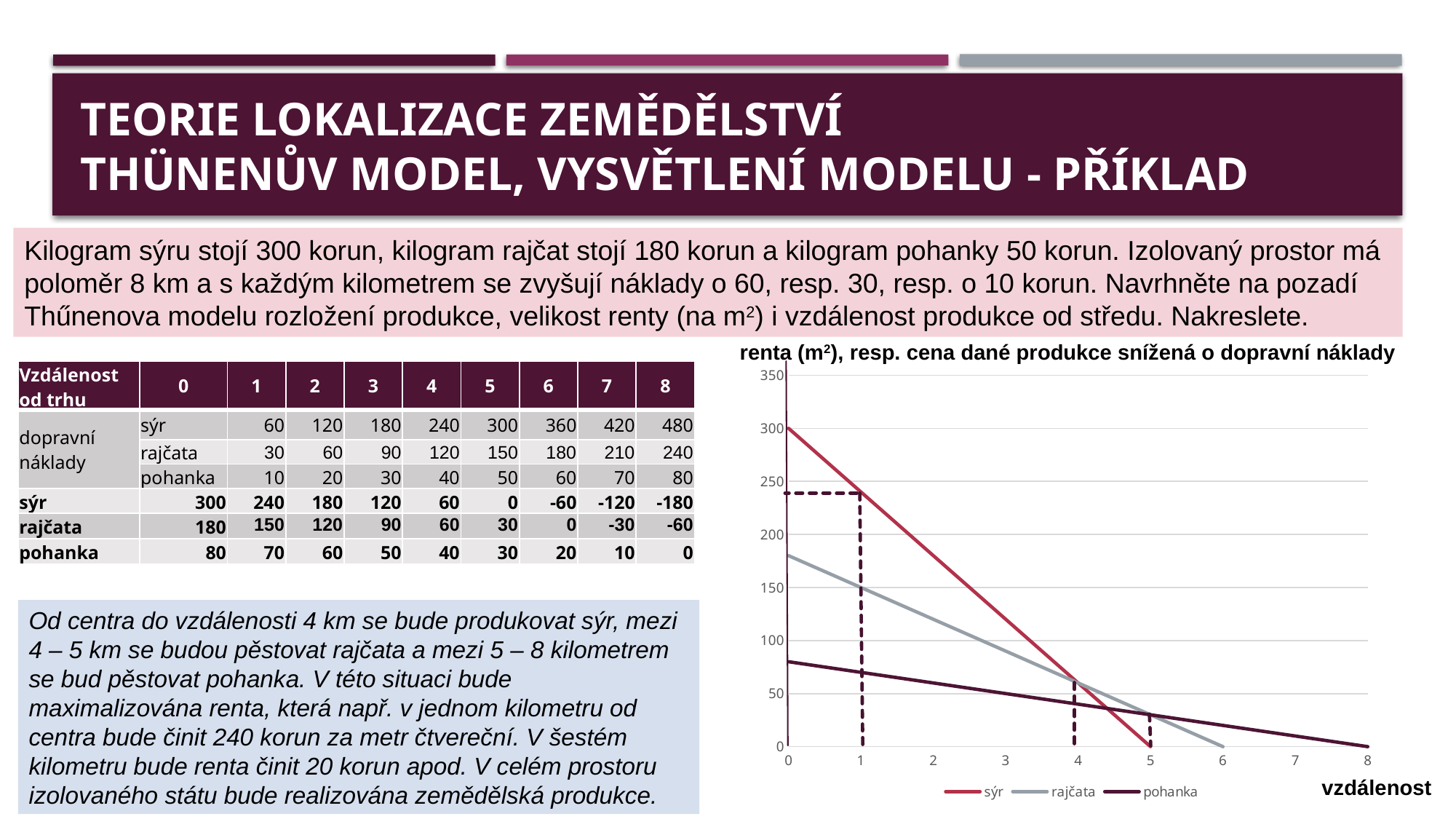
What kind of chart is shown on the slide? line chart Which series are listed in the chart legend? sýr, rajčata, pohanka Is the value of the pohanka line at distance 0 greater or less than 100? less Which series has the lowest value at distance 0? pohanka At what distance does the pohanka line reach 0? 8 Which series has the highest value at distance 0? sýr Do the values of the sýr line rise or fall as distance increases? fall What is the value of the sýr line at distance 0? 300 At what distance does the sýr line reach 0? 5 How many series does the chart legend list? 3 Is the value of the rajčata line at distance 0 greater or less than 150? greater At what distance does the rajčata line reach 0? 6